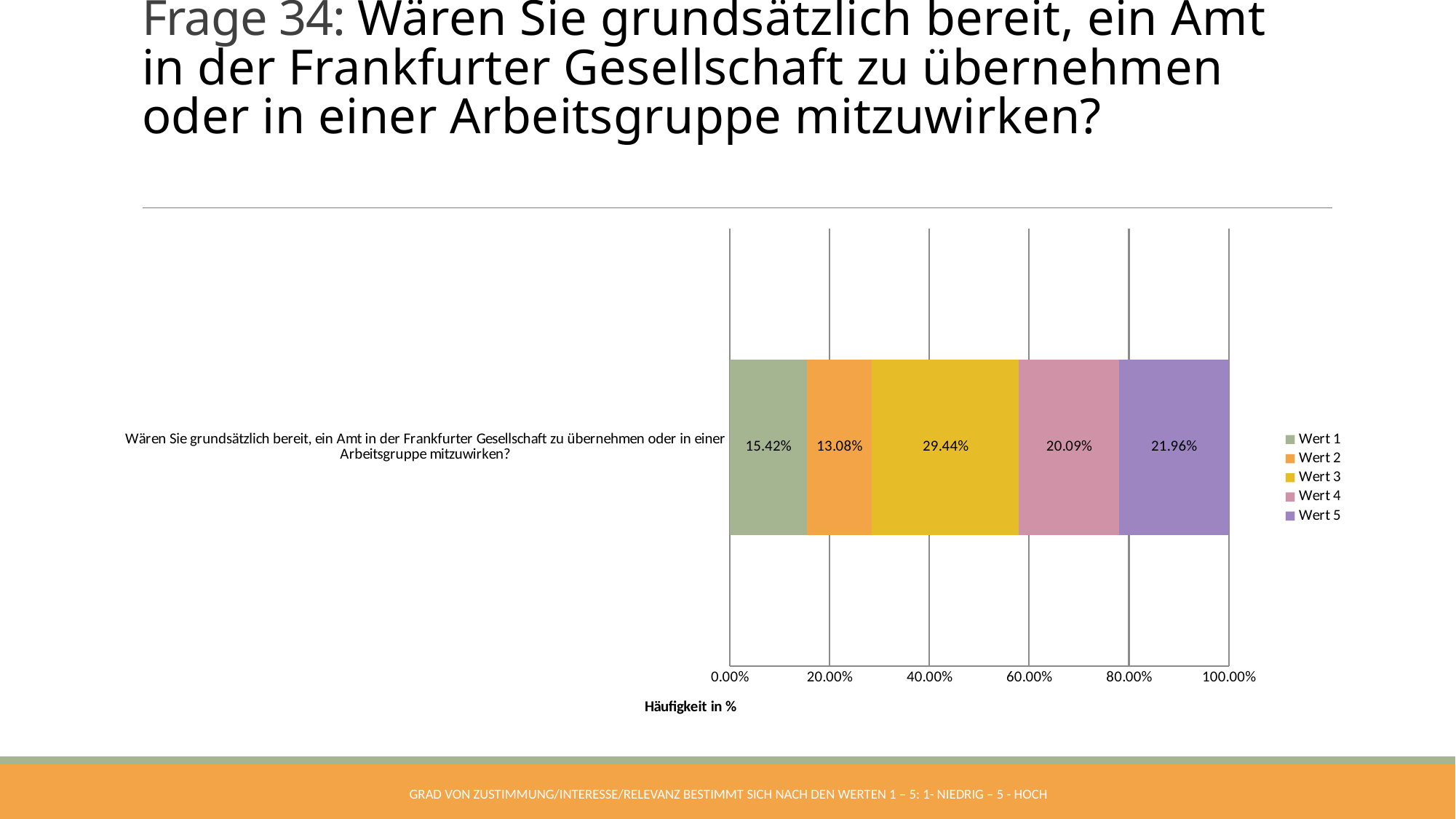
What is the total of the stacked bar? 99.99% What is the value for Wert 5? 21.96% How many series does the legend list? 5 What is the value for Wert 3? 29.44% What is the difference between the values for Wert 3 and Wert 2? 16.36% What is the value for Wert 1? 15.42% What kind of chart is shown on the slide? Stacked bar chart What is the label of the x axis? Häufigkeit in % Which is larger, the value for Wert 1 or the value for Wert 2? Wert 1 Which series has the lowest value? Wert 2 What is the difference between the values for Wert 5 and Wert 4? 1.87% Which series has the highest value? Wert 3